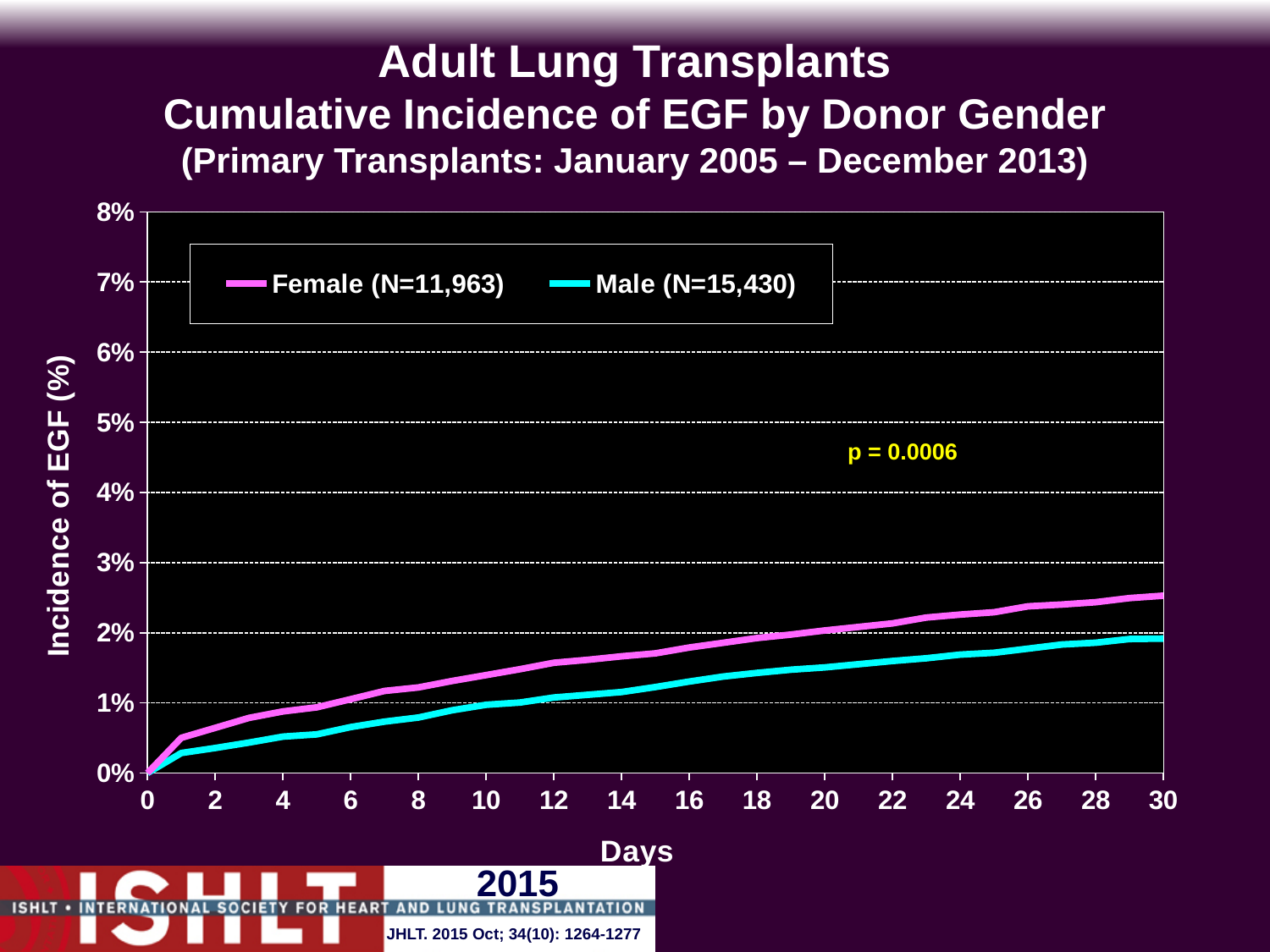
What is the N for the Female series shown in the legend? 11,963 Is the value for the Male series at day 6 greater or less than 1%? less Is the value for the Female series at day 30 greater or less than 2%? greater Do the values for the Male series rise or fall as the number of days increases? rise What kind of chart is shown on the slide? line chart How many series does the legend list? 2 What p-value is shown on the chart? p = 0.0006 Is the value for the Female series at day 10 greater or less than 1%? greater Which series has the higher cumulative incidence of EGF at day 30, Female or Male? Female Do the values for the Female series rise or fall as the number of days increases? rise